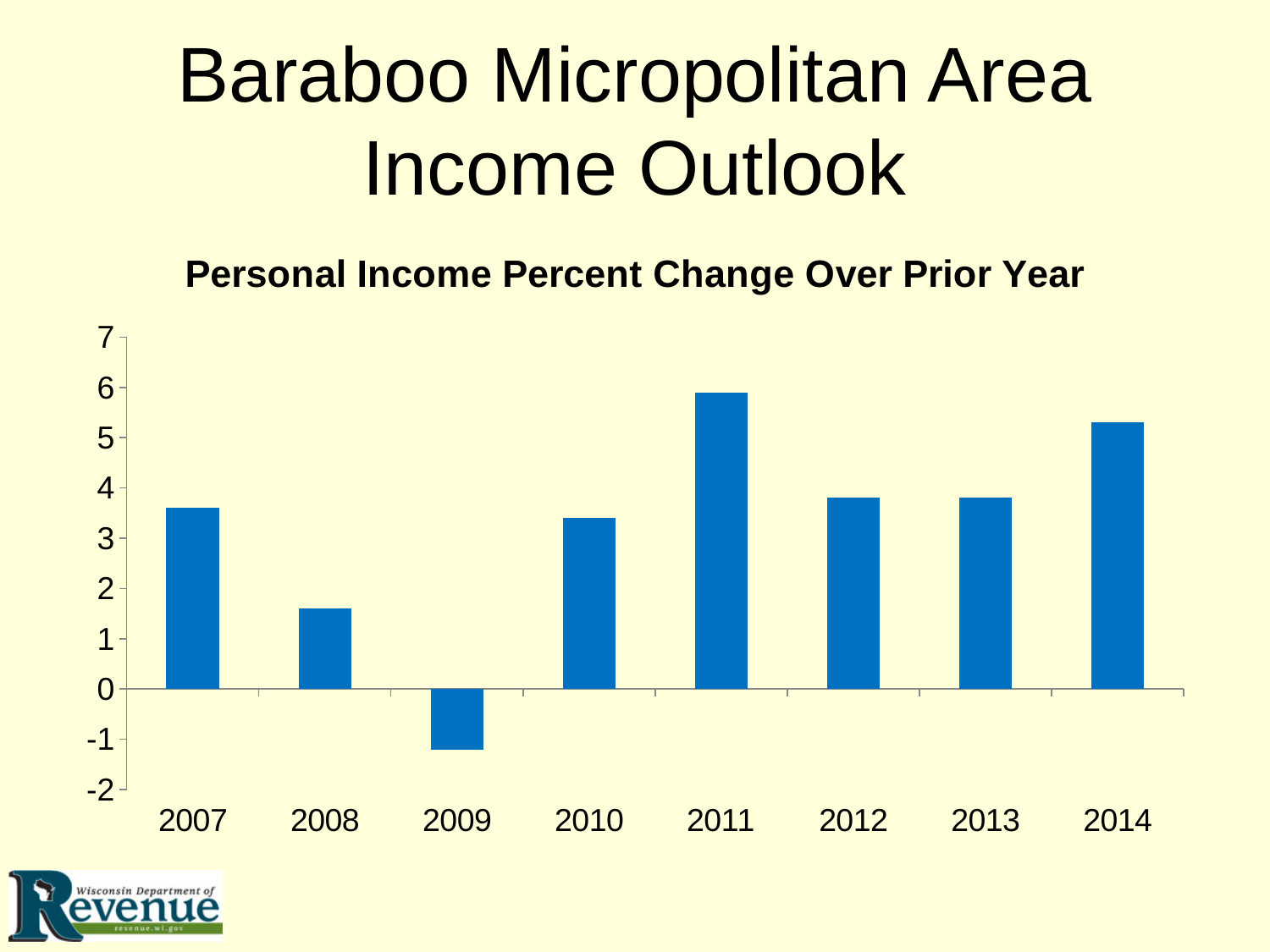
Which year has the highest personal income percent change? 2011 What is the title of the chart? Personal Income Percent Change Over Prior Year Is the value for 2009 greater or less than 0? less What kind of chart is shown on the slide? bar chart Do the values rise or fall from 2009 to 2011? rise Is the value for 2008 greater or less than 1? greater Which year has the larger value, 2007 or 2008? 2007 How many years are shown on the x axis of the chart? 8 Which year has the lowest personal income percent change? 2009 Is the value for 2007 greater or less than 4? less Which year has the larger value, 2011 or 2014? 2011